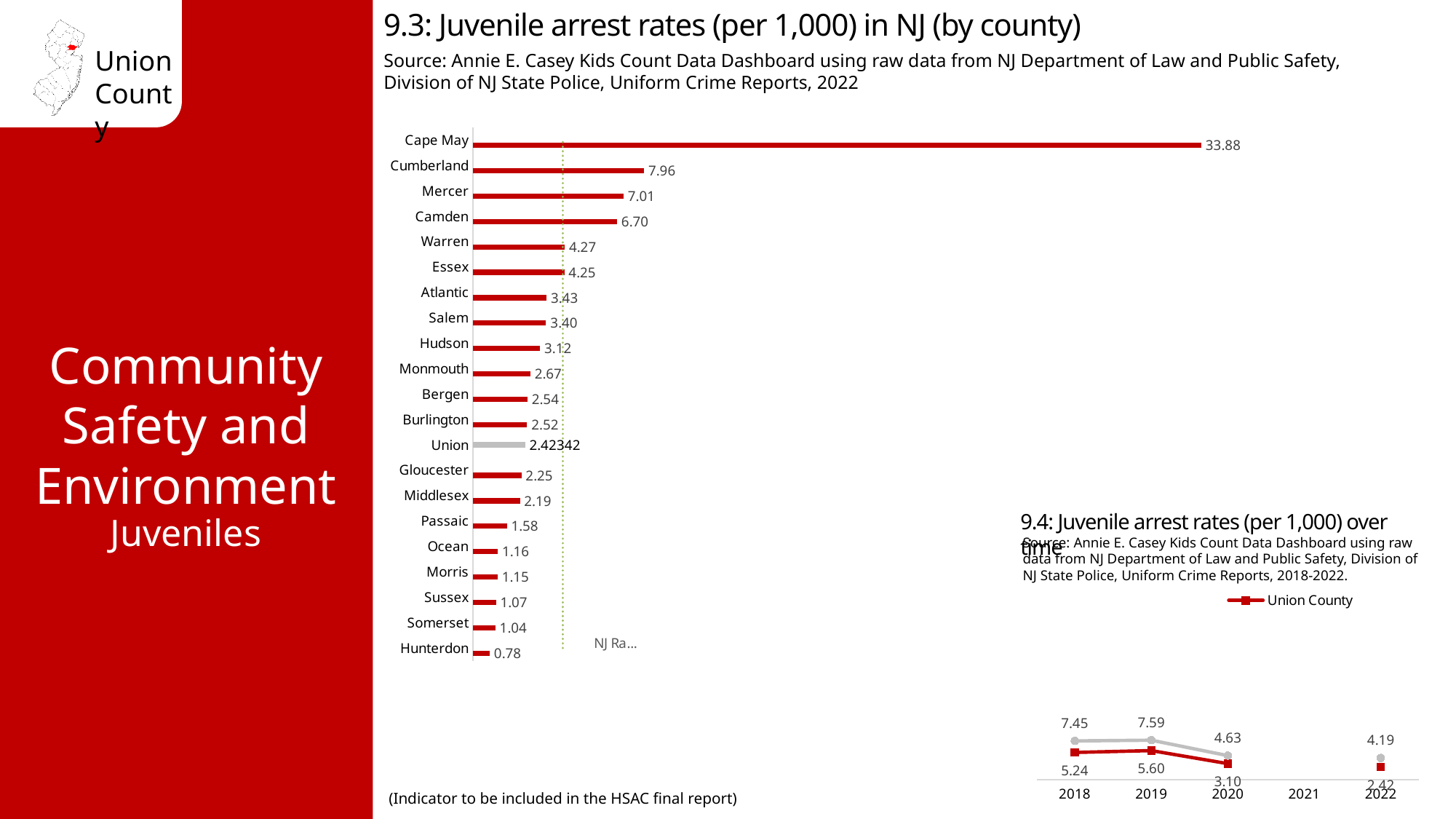
In the chart '9.3: Juvenile arrest rates (per 1,000) in NJ (by county)', which has a higher value, Warren or Essex? Warren In the chart '9.3: Juvenile arrest rates (per 1,000) in NJ (by county)', what is the value for Cumberland? 7.96 In the chart '9.4: Juvenile arrest rates (per 1,000) over time', what is the Union County value for 2022? 2.42 In the chart '9.3: Juvenile arrest rates (per 1,000) in NJ (by county)', which county has the lowest juvenile arrest rate? Hunterdon In the chart '9.3: Juvenile arrest rates (per 1,000) in NJ (by county)', which county has the highest juvenile arrest rate? Cape May In the chart '9.4: Juvenile arrest rates (per 1,000) over time', what is the difference between the Union County values for 2019 and 2020? 2.50 In the chart '9.3: Juvenile arrest rates (per 1,000) in NJ (by county)', what is the difference between the values for Mercer and Camden? 0.31 What kind of chart is '9.3: Juvenile arrest rates (per 1,000) in NJ (by county)'? Bar chart In the chart '9.4: Juvenile arrest rates (per 1,000) over time', what is the Union County value for 2019? 5.60 In the chart '9.3: Juvenile arrest rates (per 1,000) in NJ (by county)', how many counties are shown? 21 In the chart '9.3: Juvenile arrest rates (per 1,000) in NJ (by county)', what is the juvenile arrest rate for Cape May? 33.88 In the chart '9.3: Juvenile arrest rates (per 1,000) in NJ (by county)', what is the value for Passaic? 1.58